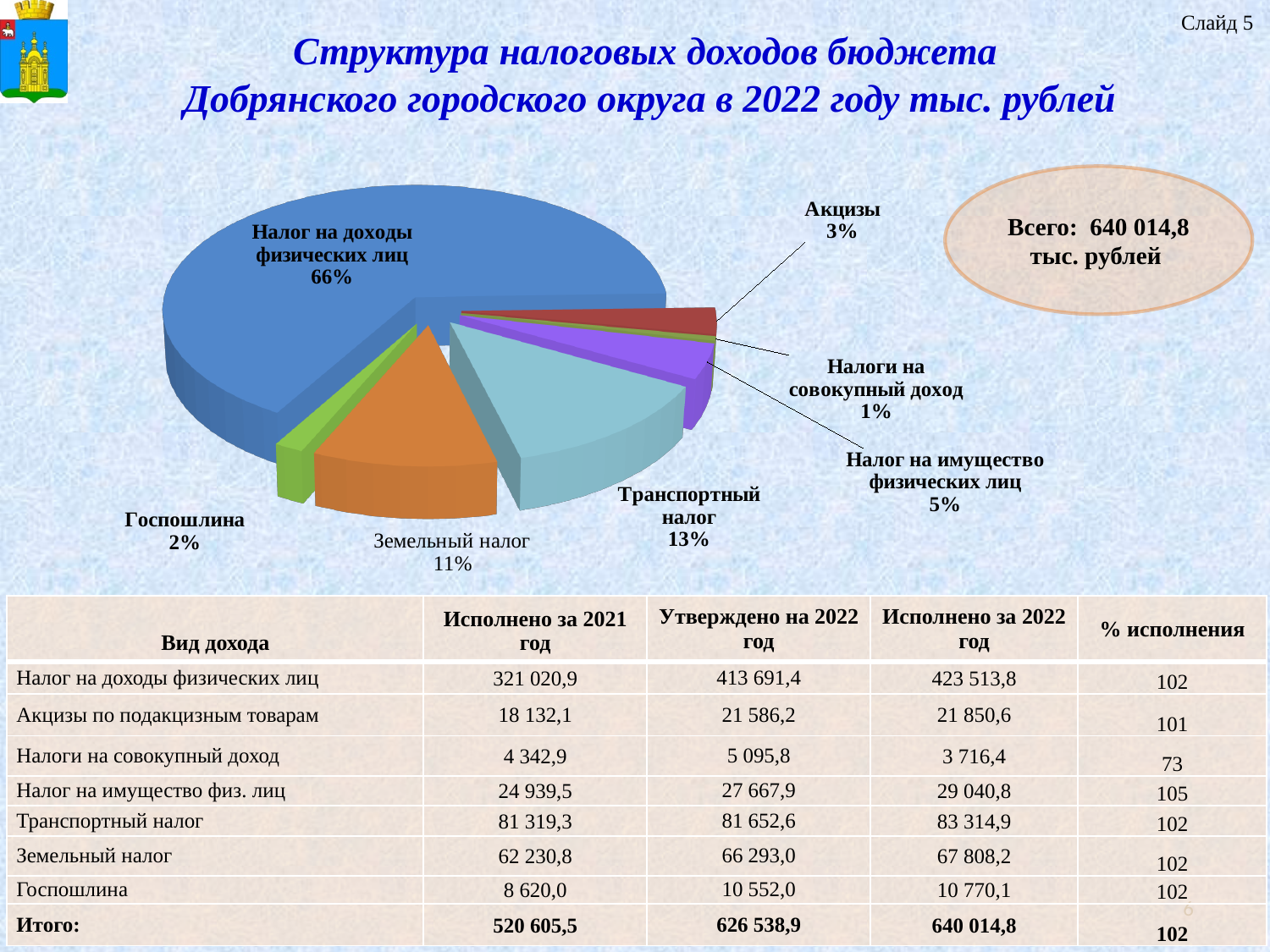
What is the difference in percentage points between the shares of "Транспортный налог" and "Земельный налог"? 2 Which has the larger share: "Госпошлина" or "Налог на имущество физических лиц"? Налог на имущество физических лиц What share of the pie does "Акцизы" have? 3% What share of the pie does "Налог на доходы физических лиц" have? 66% What share of the pie does "Транспортный налог" have? 13% What total amount in thousand rubles is shown in the oval next to the pie chart? 640 014,8 How many slices does the pie chart have? 7 Which slice of the pie is the smallest? Налоги на совокупный доход What kind of chart is shown on the slide? pie chart What share of the pie does "Налог на имущество физических лиц" have? 5% Which slice of the pie is the largest? Налог на доходы физических лиц What share of the pie does "Земельный налог" have? 11%